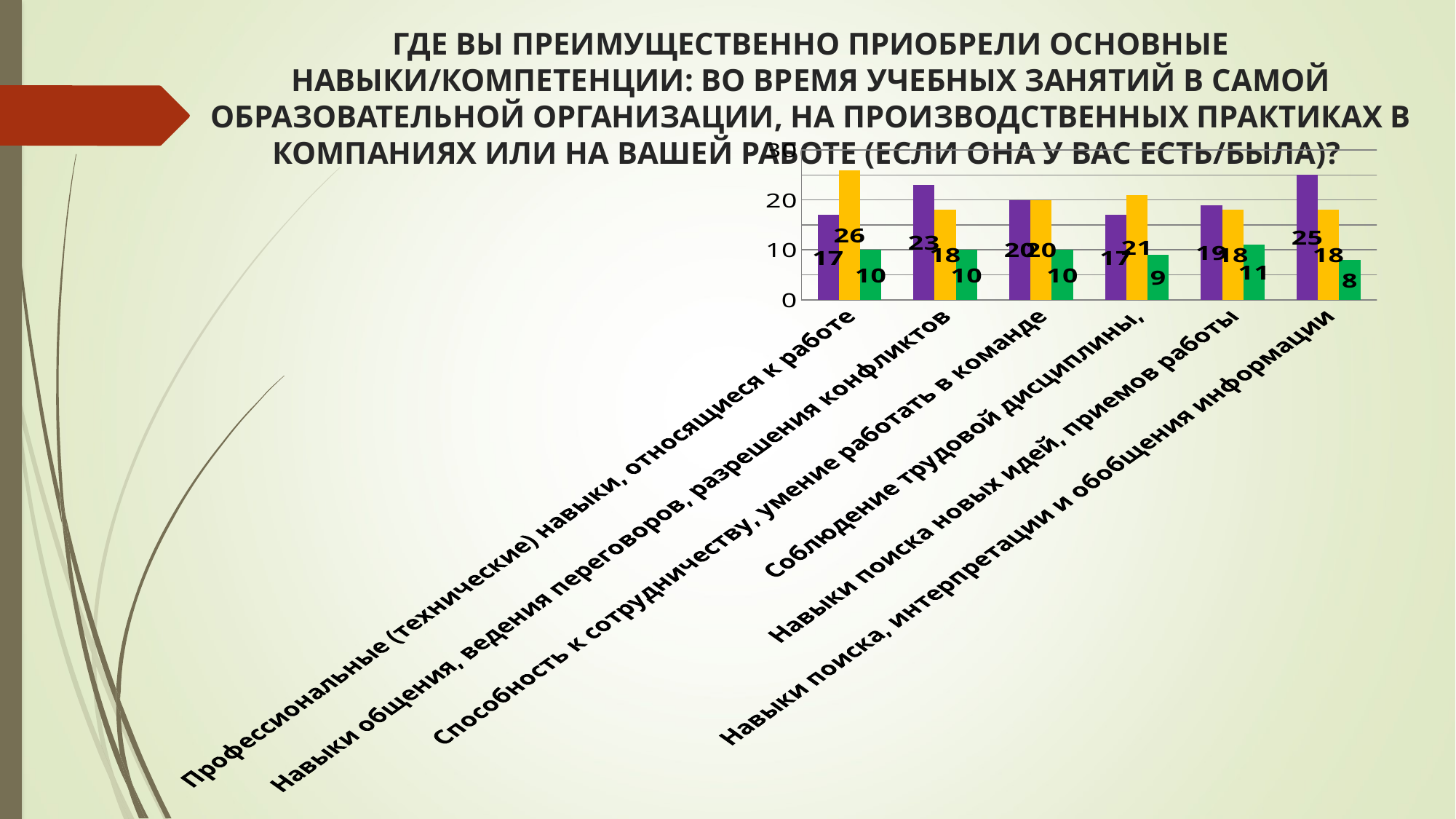
What is the value of the yellow bar for 'Профессиональные (технические) навыки, относящиеся к работе'? 26 How many categories are shown on the x axis of the chart? 6 What is the value of the purple bar for 'Навыки общения, ведения переговоров, разрешения конфликтов'? 23 What kind of chart is shown on the slide? bar chart What is the difference between the yellow bar and the green bar for 'Профессиональные (технические) навыки, относящиеся к работе'? 16 What is the value of the purple bar for 'Навыки поиска, интерпретации и обобщения информации'? 25 Which category has the highest yellow bar? Профессиональные (технические) навыки, относящиеся к работе Which category has the lowest green bar? Навыки поиска, интерпретации и обобщения информации Is the value of the purple bar for 'Навыки поиска, интерпретации и обобщения информации' greater or less than 20? greater What colours are the three series of bars in the chart? purple, yellow and green What is the value of the green bar for 'Навыки поиска новых идей, приемов работы'? 11 For 'Соблюдение трудовой дисциплины', which is larger: the purple bar or the yellow bar? the yellow bar